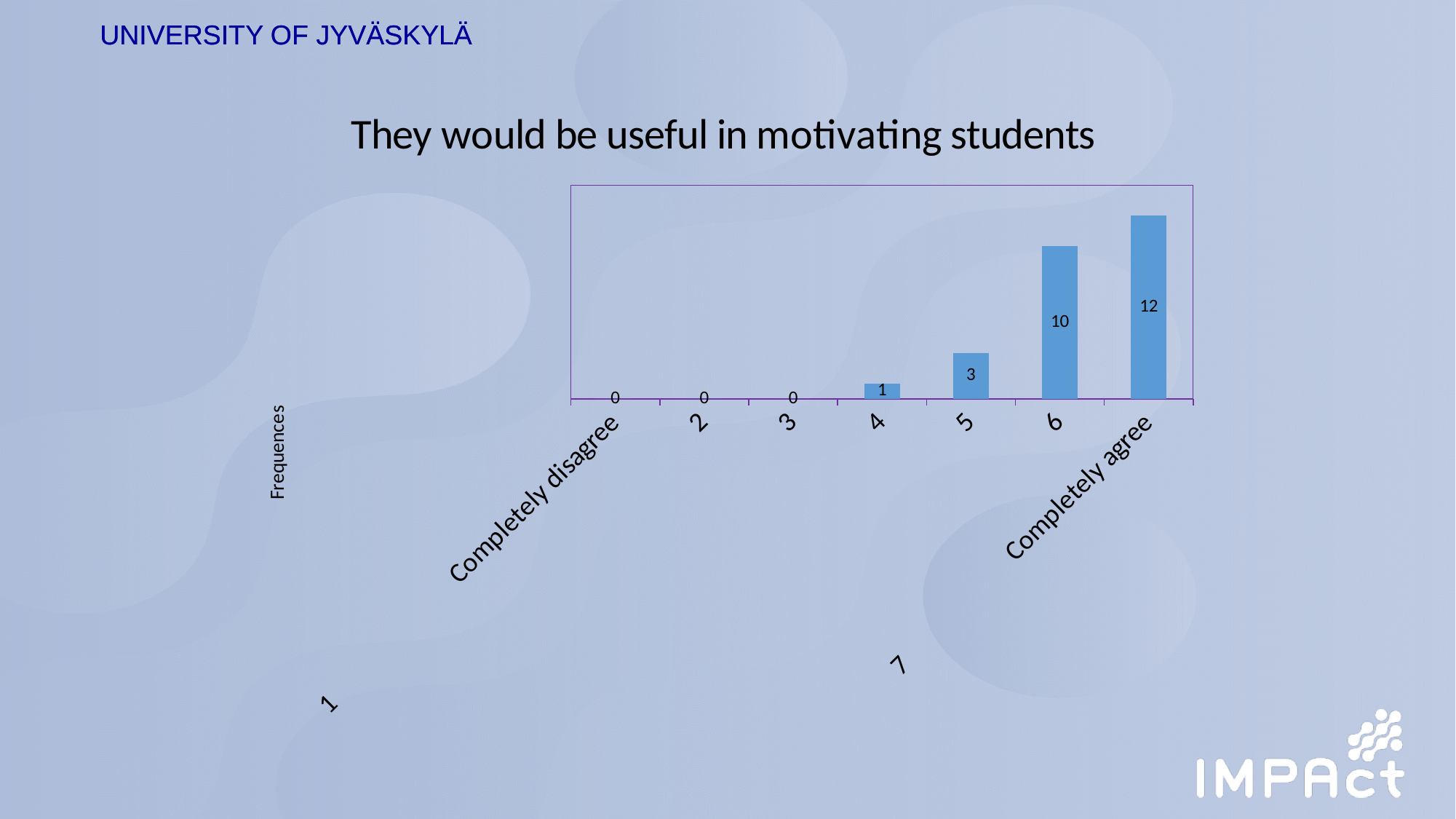
What is the difference between the values for "Completely agree" and category 6? 2 What is the value for "Completely agree"? 12 How many categories are shown on the x axis? 7 What kind of chart is shown on the slide? Bar chart What is the value for category 6? 10 What is the value for category 4? 1 What is the title of the chart? They would be useful in motivating students What is the value for "Completely disagree"? 0 Which category has the highest value? Completely agree What is the value for category 5? 3 Which is larger, the value for category 5 or the value for category 6? Category 6 Do the values rise or fall from "Completely disagree" to "Completely agree"? Rise